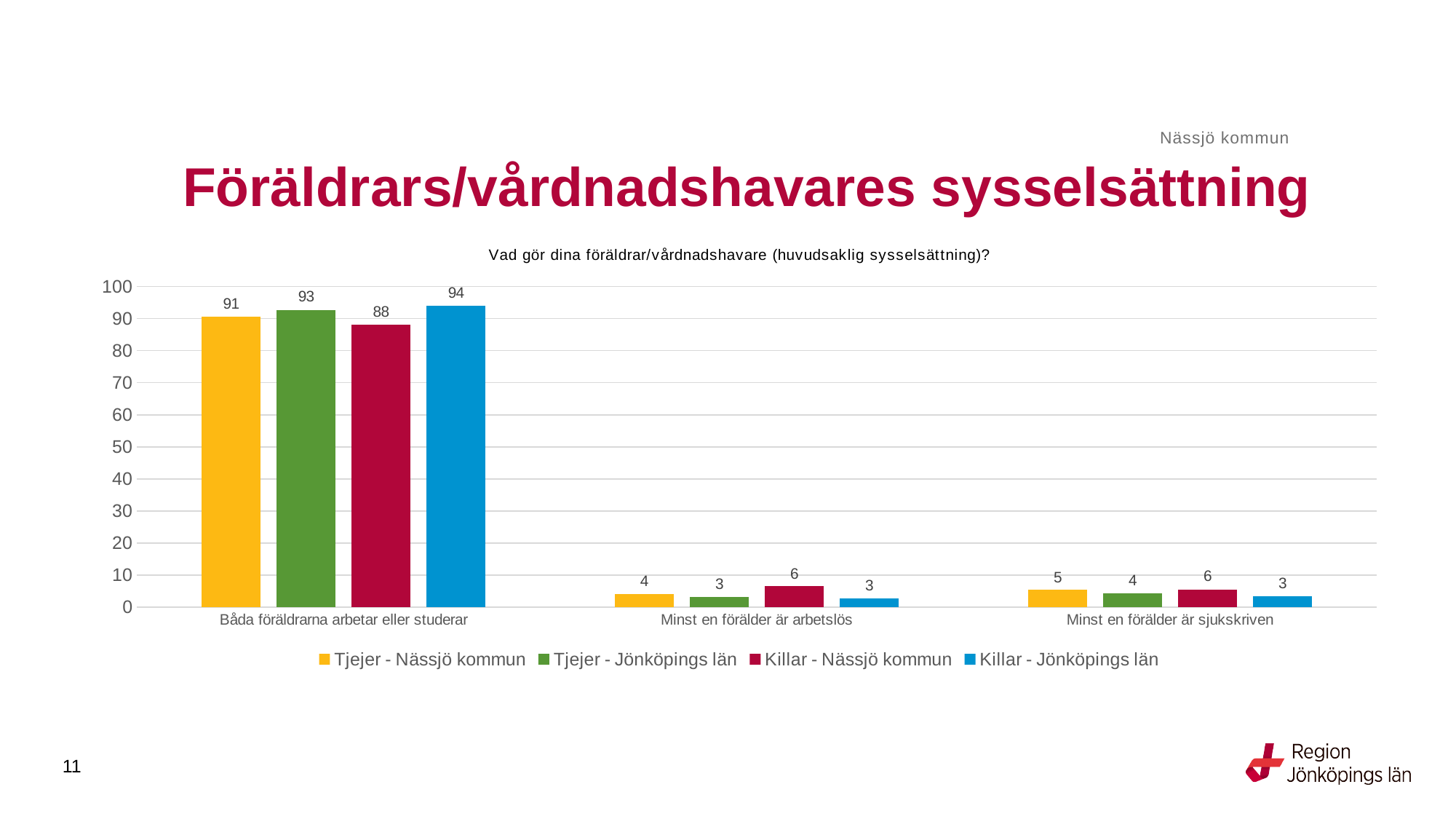
What is the value for Killar - Nässjö kommun in the category 'Minst en förälder är arbetslös'? 6 What is the chart's title (the question shown above the chart)? Vad gör dina föräldrar/vårdnadshavare (huvudsaklig sysselsättning)? Which series has the highest value in the category 'Båda föräldrarna arbetar eller studerar'? Killar - Jönköpings län How many categories are shown on the x axis? 3 What is the difference between Killar - Jönköpings län and Killar - Nässjö kommun in the category 'Båda föräldrarna arbetar eller studerar'? 6 What kind of chart is shown on the slide? Bar chart How many series does the legend list? 4 Which series has the lowest value in the category 'Båda föräldrarna arbetar eller studerar'? Killar - Nässjö kommun What is the value for Killar - Jönköpings län in the category 'Minst en förälder är sjukskriven'? 3 What is the value for Tjejer - Nässjö kommun in the category 'Båda föräldrarna arbetar eller studerar'? 91 Is the value for Killar - Nässjö kommun in 'Båda föräldrarna arbetar eller studerar' greater or less than 80? greater Which is larger in the category 'Minst en förälder är sjukskriven': Tjejer - Nässjö kommun or Tjejer - Jönköpings län? Tjejer - Nässjö kommun